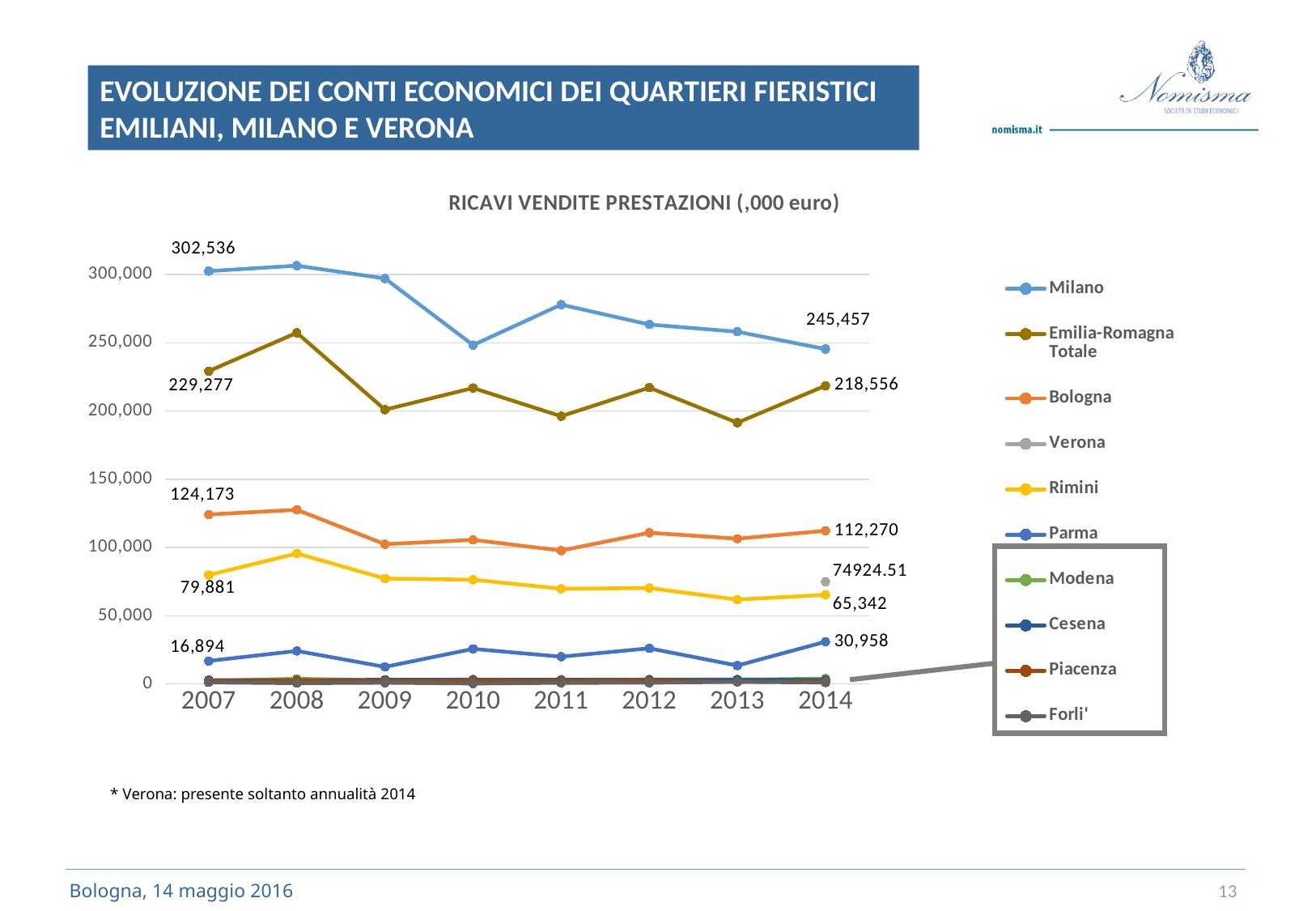
How many series does the legend list? 10 Which is larger in 2014, the value for Rimini or the value for Verona? Verona What is the value for Milano in 2007? 302,536 By how much did the value for Milano decrease from 2007 to 2014? 57,079 What is the value for Emilia-Romagna Totale in 2014? 218,556 How many years are shown on the x axis? 8 What is the value for Verona in 2014? 74924.51 What is the value for Bologna in 2007? 124,173 What type of chart is shown on the slide? line chart What is the value for Milano in 2014? 245,457 Is the value for Emilia-Romagna Totale in 2013 greater or less than 200,000? less What is the value for Parma in 2014? 30,958